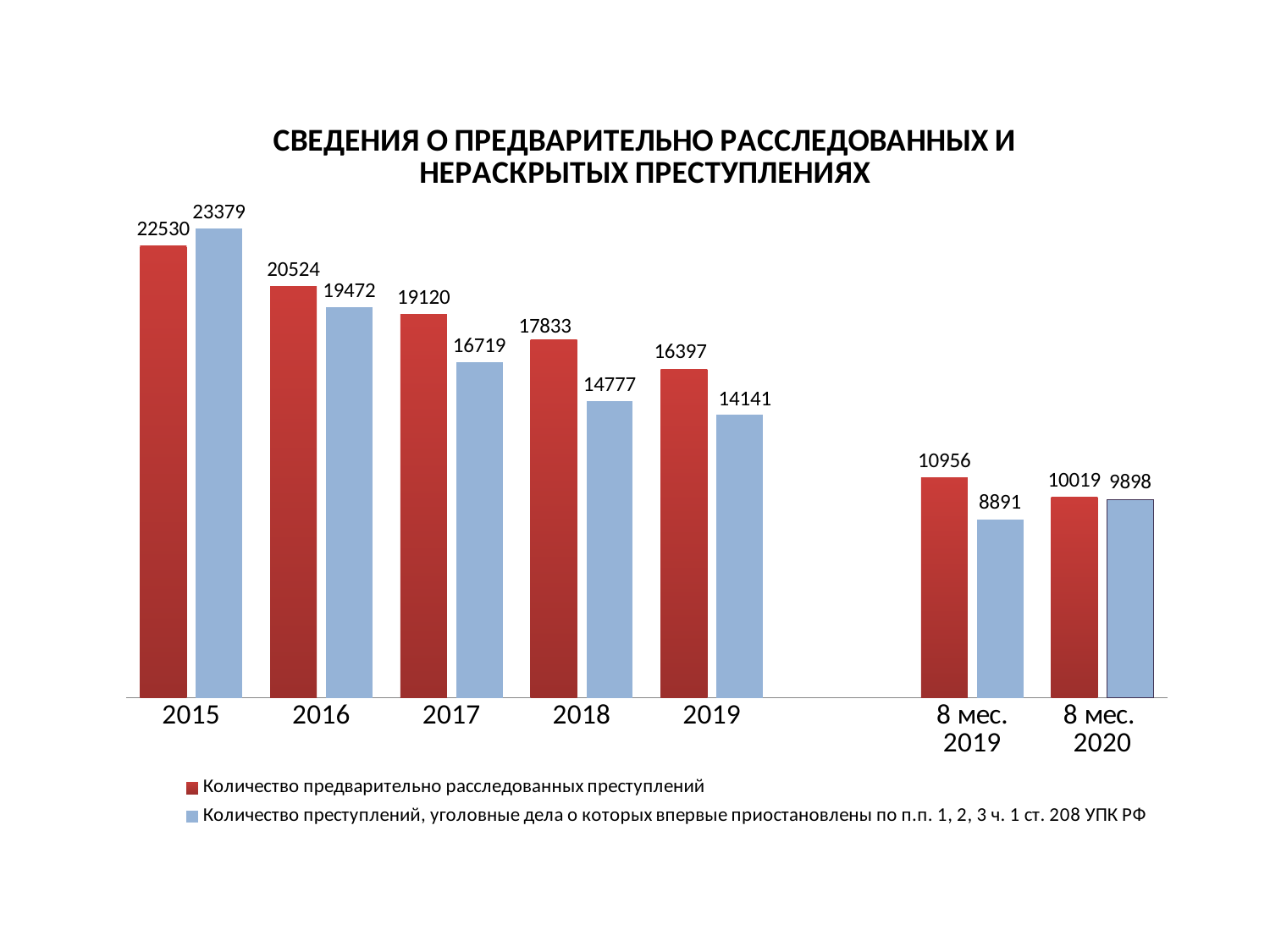
What is the value for 2018 in the series 'Количество преступлений, уголовные дела о которых впервые приостановлены по п.п. 1, 2, 3 ч. 1 ст. 208 УПК РФ'? 14777 How many categories are shown on the x axis? 7 For 2015, which series has the larger value: 'Количество предварительно расследованных преступлений' or 'Количество преступлений, уголовные дела о которых впервые приостановлены по п.п. 1, 2, 3 ч. 1 ст. 208 УПК РФ'? Количество преступлений, уголовные дела о которых впервые приостановлены по п.п. 1, 2, 3 ч. 1 ст. 208 УПК РФ Which category has the lowest value in the series 'Количество преступлений, уголовные дела о которых впервые приостановлены по п.п. 1, 2, 3 ч. 1 ст. 208 УПК РФ'? 8 мес. 2019 What is the value for '8 мес. 2020' in the series 'Количество предварительно расследованных преступлений'? 10019 How many series does the legend list? 2 What is the difference between the two series' values for 2019? 2256 What is the difference between the 'Количество предварительно расследованных преступлений' values for 2015 and 2016? 2006 Do the values of 'Количество предварительно расследованных преступлений' rise or fall from 2015 to 2019? Fall Which category has the highest value in the series 'Количество предварительно расследованных преступлений'? 2015 What kind of chart is shown on the slide? Bar chart What is the value for 2017 in the series 'Количество предварительно расследованных преступлений'? 19120